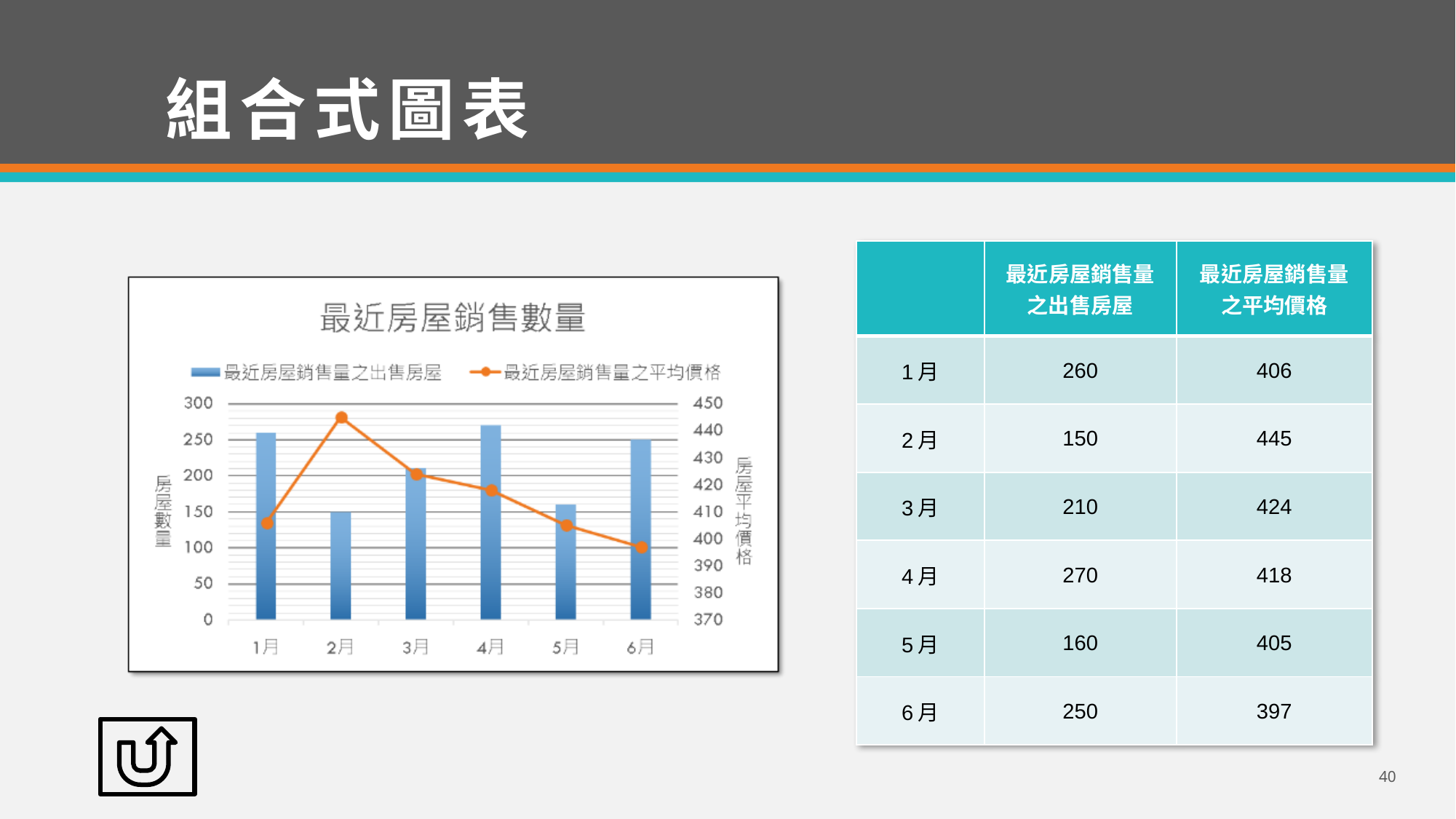
What is the value of 最近房屋銷售量之平均價格 for 2月? 445 How many months are shown on the x axis of the chart? 6 Is the 最近房屋銷售量之出售房屋 value for 6月 greater or less than 200? greater From 2月 to 6月, does the 最近房屋銷售量之平均價格 line rise or fall? fall What is the value of 最近房屋銷售量之出售房屋 for 4月? 270 What kind of chart is shown on the slide? Combination bar and line chart Which is larger, the 最近房屋銷售量之出售房屋 value for 3月 or for 5月? 3月 How many series does the chart legend list? 2 What is the title of the chart? 最近房屋銷售數量 Which month has the lowest 最近房屋銷售量之出售房屋? 2月 Which month has the highest 最近房屋銷售量之平均價格? 2月 What is the difference between the 最近房屋銷售量之出售房屋 values for 1月 and 2月? 110